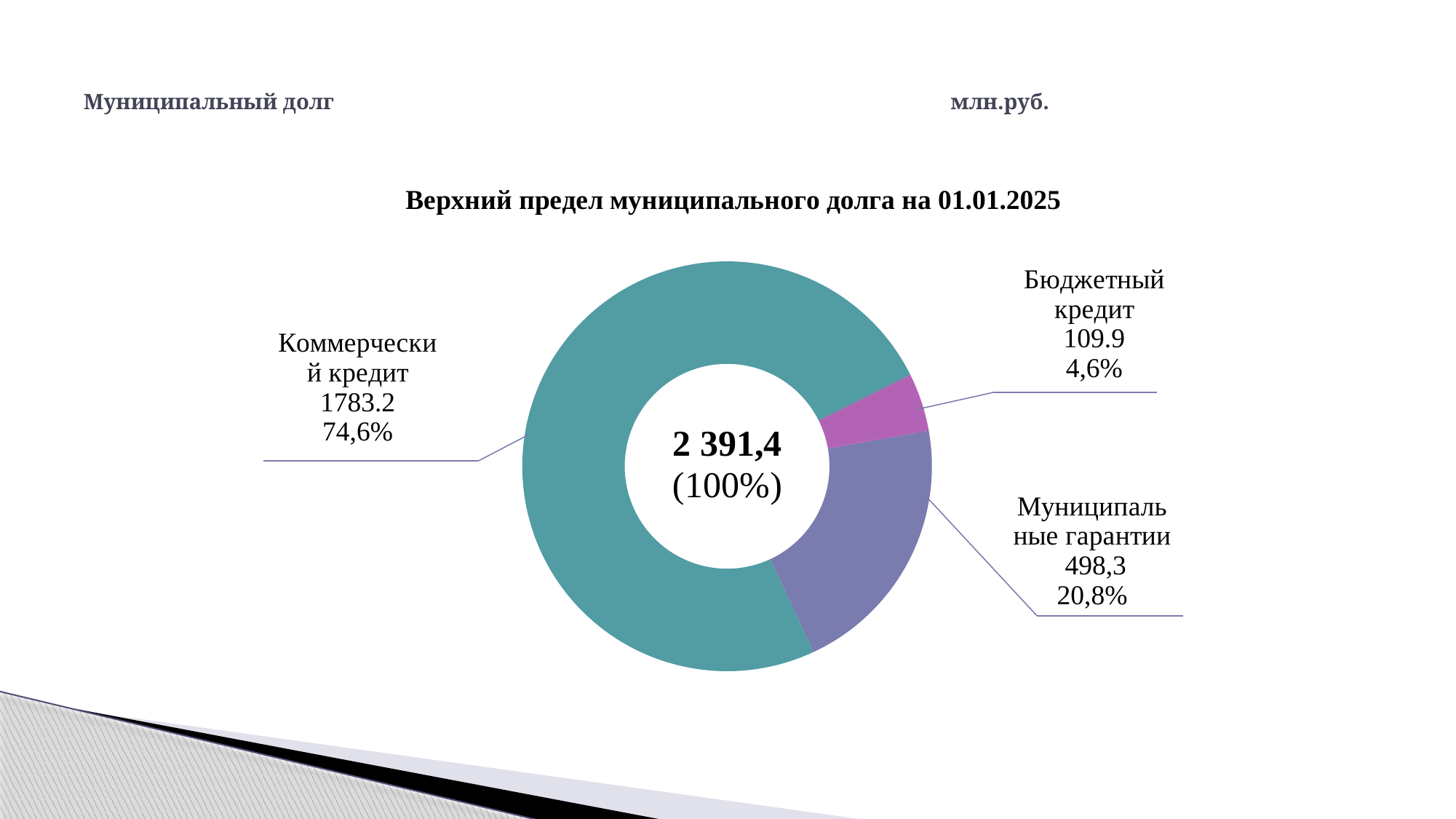
What is the value for Муниципальные гарантии? 498,3 Which category has the smallest share? Бюджетный кредит How many categories does the chart show? 3 Which category has the largest share? Коммерческий кредит What kind of chart is shown on the slide? Pie chart (donut) What is the title of the chart? Верхний предел муниципального долга на 01.01.2025 What is the value for Коммерческий кредит? 1783.2 What is the value for Бюджетный кредит? 109.9 What share of the total does Бюджетный кредит represent? 4,6% By how many percentage points does the share of Коммерческий кредит exceed the share of Муниципальные гарантии? 53,8% What is the total value shown in the centre of the chart? 2 391,4 What share of the total does Муниципальные гарантии represent? 20,8%